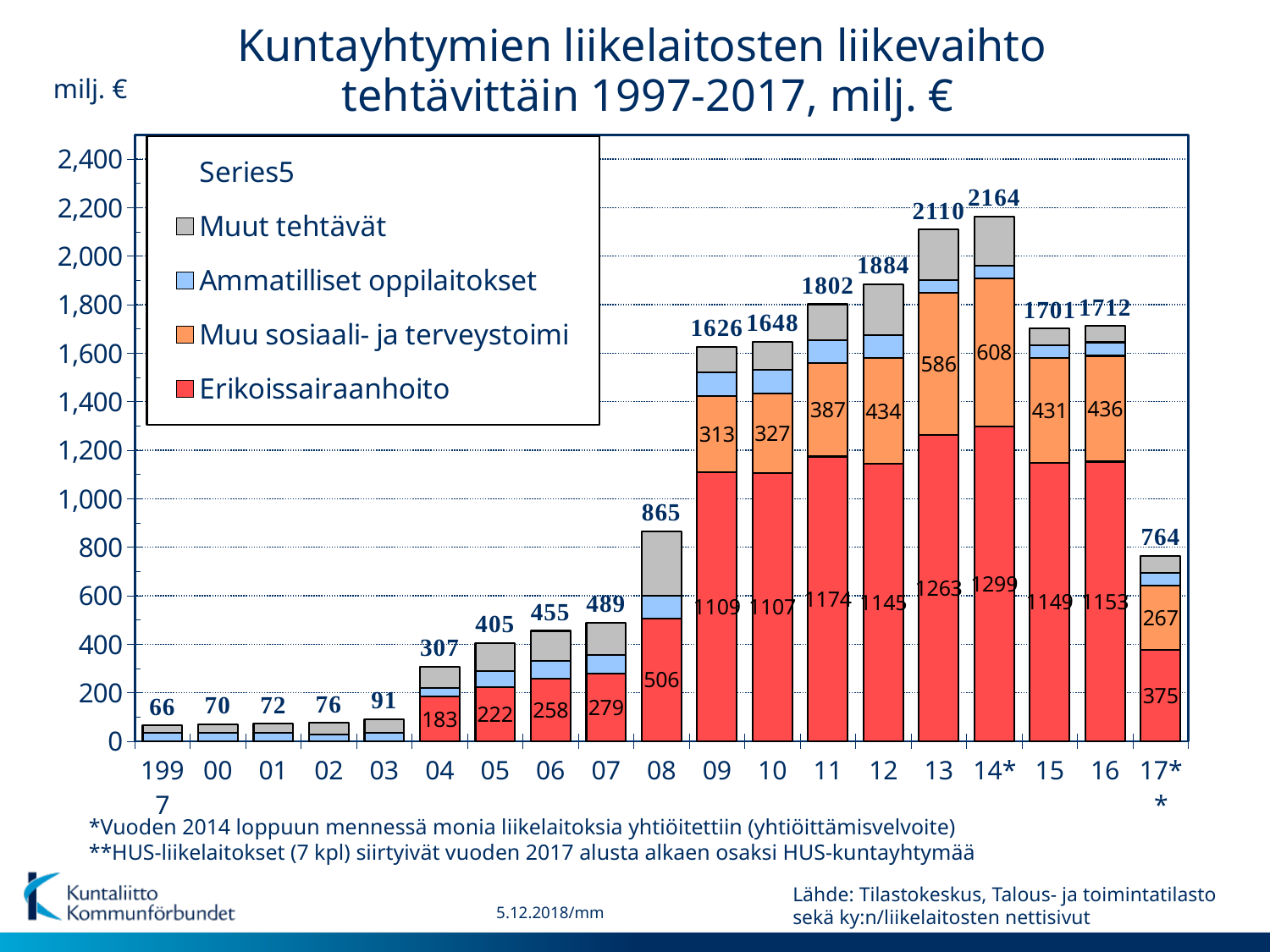
How many bars (years) are shown in the chart? 19 By how much does the total for 14* exceed the total for 2013? 54 Which year has the highest total turnover (liikevaihto) in the chart? 14* Which year has the lowest total turnover in the chart? 1997 What is the Erikoissairaanhoito value for 2013? 1263 Which is larger, the Erikoissairaanhoito value for 2011 or for 2012? 2011 What is the total turnover shown above the bar for 2008? 865 What is the difference between the Muu sosiaali- ja terveystoimi values for 2016 and 2015? 5 What kind of chart is shown on the slide? Stacked bar chart What is the Muu sosiaali- ja terveystoimi value for 14*? 608 What is the total turnover for 1997? 66 What colour represents Erikoissairaanhoito in the legend? Red